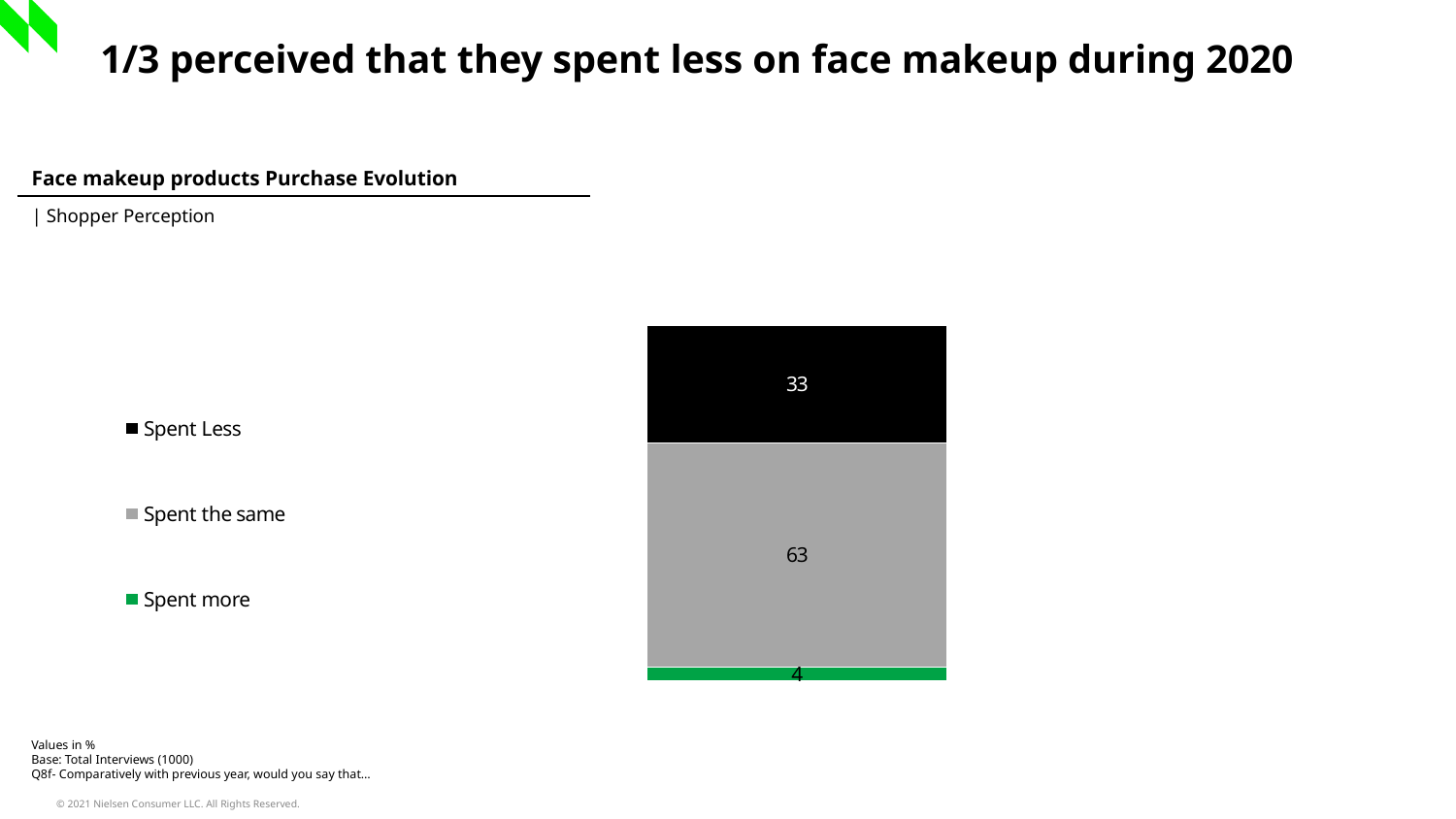
What value is shown for the 'Spent the same' segment of the stacked bar? 63 What colour is the 'Spent more' segment in the chart? Green Which segment of the stacked bar has the largest value? Spent the same How many series does the legend list? 3 What value is shown for the 'Spent more' segment of the stacked bar? 4 What is the difference between the 'Spent the same' and 'Spent Less' values? 30 What kind of chart is shown on the slide? Stacked bar chart Which segment of the stacked bar has the smallest value? Spent more What value is shown for the 'Spent Less' segment of the stacked bar? 33 What is the title of the chart section on the slide? Face makeup products Purchase Evolution Which is larger, the value for 'Spent Less' or the value for 'Spent more'? Spent Less What is the total of all segments in the stacked bar? 100